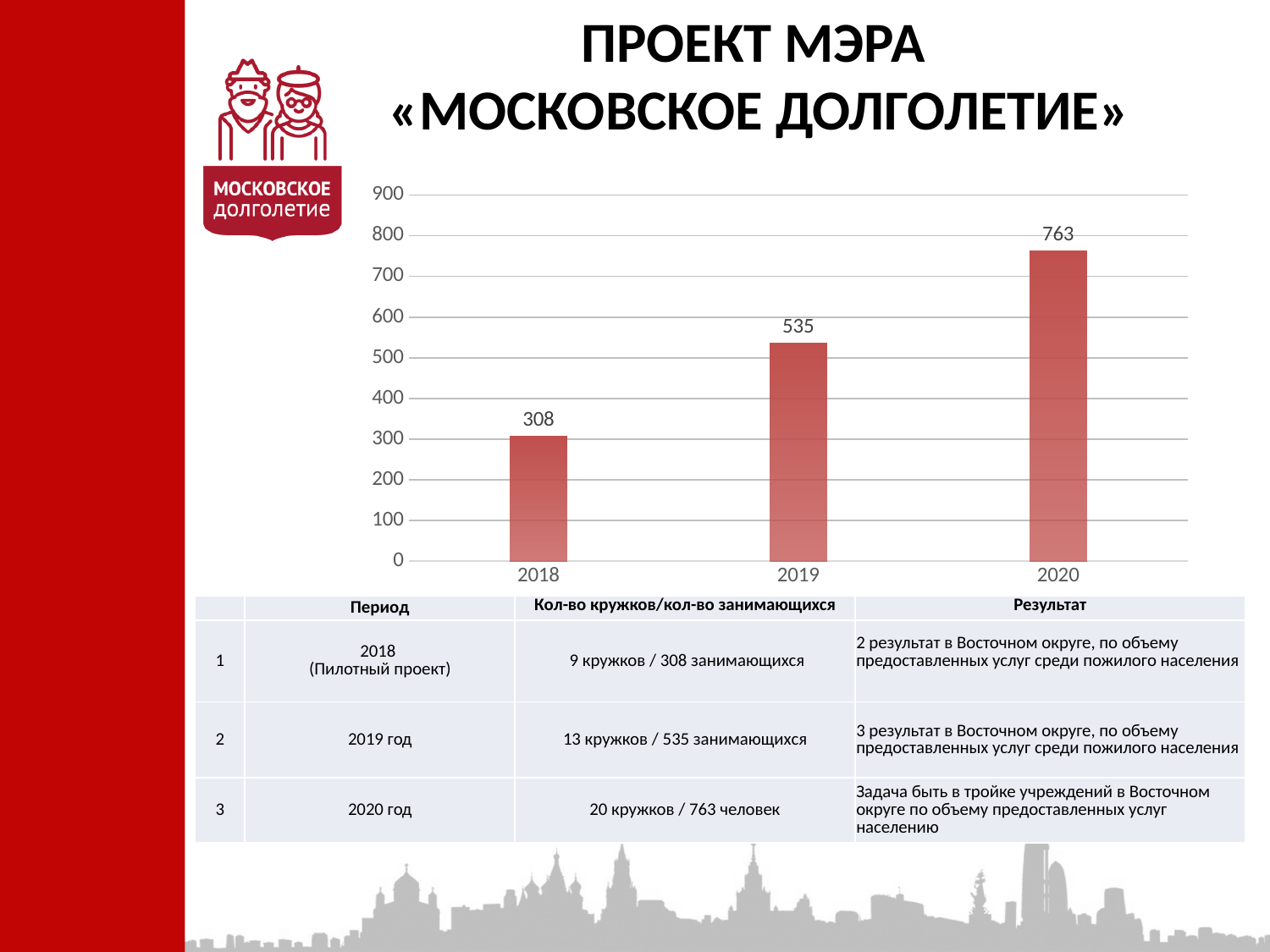
What is the value for 2020? 763 What is the value for 2019? 535 What is the difference between the values for 2020 and 2019? 228 What is the value for 2018? 308 What is the difference between the values for 2019 and 2018? 227 Do the values rise or fall from 2018 to 2020? rise Which year has the highest value? 2020 What kind of chart is shown on the slide? bar chart Which is larger, the value for 2018 or the value for 2019? 2019 Is the value for 2020 greater or less than 700? greater How many years are shown on the x axis? 3 Which year has the lowest value? 2018